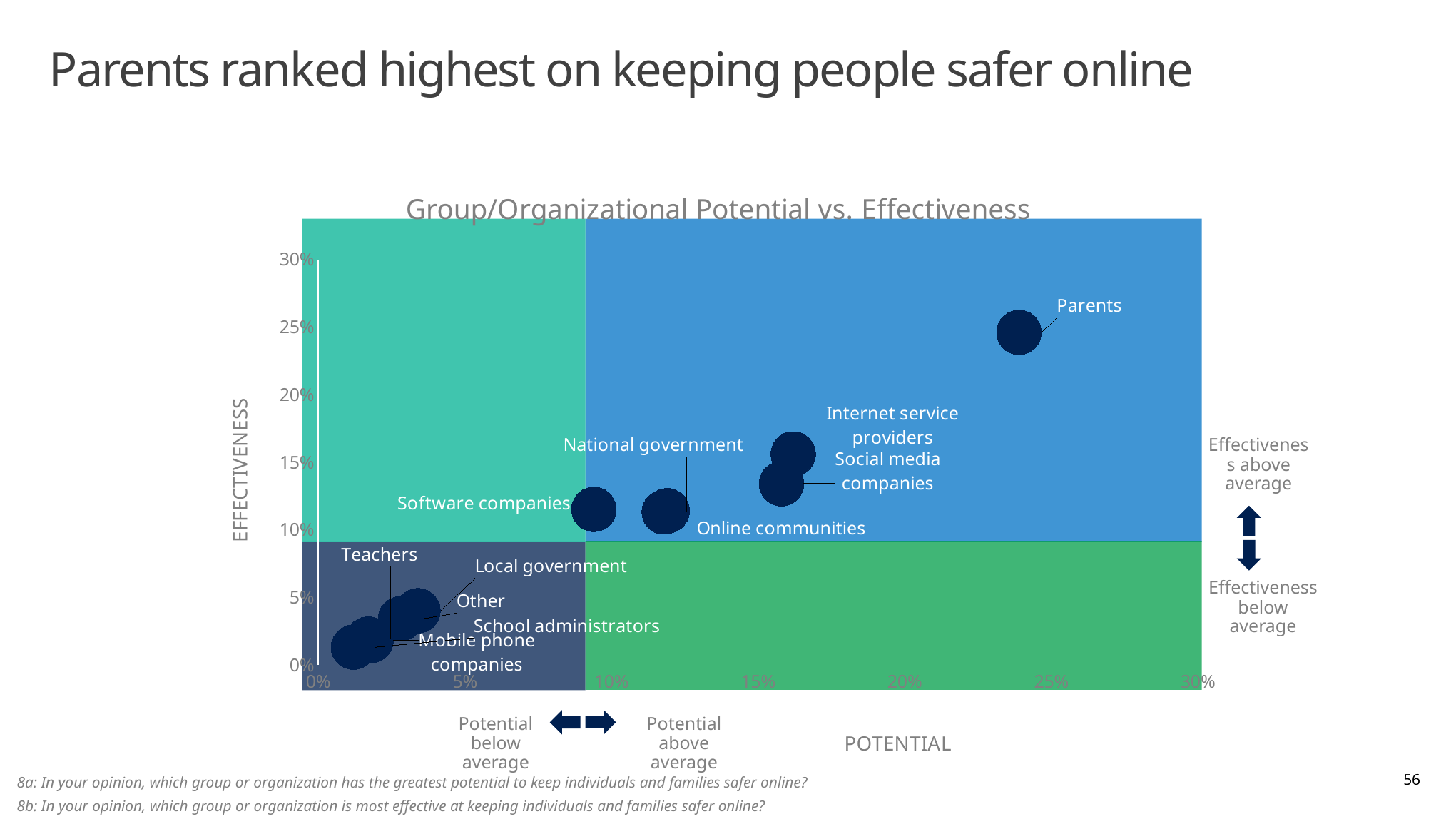
Is the effectiveness value for Parents greater or less than 20%? greater What is the title of the chart? Group/Organizational Potential vs. Effectiveness Is the effectiveness value for Teachers greater or less than 5%? less Which has higher effectiveness, Parents or Social media companies? Parents Is the potential value for Internet service providers greater or less than 10%? greater Which group has the highest potential in the chart? Parents What does the vertical axis of the chart measure? Effectiveness Which group has the highest effectiveness in the chart? Parents How many groups/organizations are labelled in the chart? 11 Which has higher potential, Teachers or Online communities? Online communities What kind of chart is shown on the slide? Scatter (bubble) chart